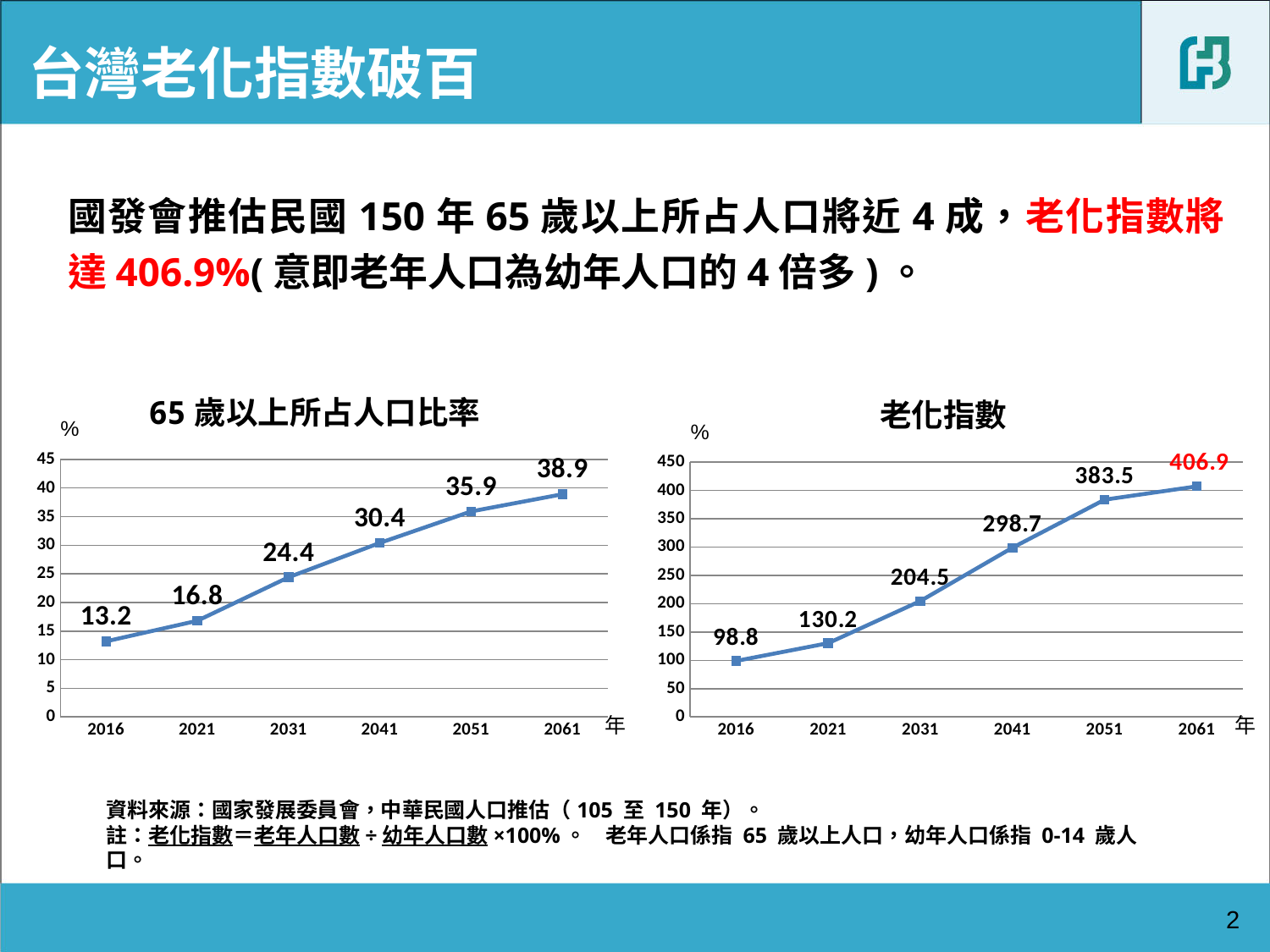
In the chart titled 老化指數, which year has the lowest value? 2016 In the chart titled 老化指數, what is the difference between the values for 2061 and 2016? 308.1 In the chart titled 老化指數, what is the value for 2016? 98.8 What kind of chart is the chart titled 老化指數? line chart In the chart titled 老化指數, which data label is shown in red? 406.9 In the chart titled 老化指數, do the values rise or fall from 2016 to 2061? rise In the chart titled 65歲以上所占人口比率, which year has the highest value? 2061 How many data points are plotted in the chart titled 65歲以上所占人口比率? 6 In the chart titled 65歲以上所占人口比率, what is the value for 2031? 24.4 In the chart titled 老化指數, what is the value for 2041? 298.7 In the chart titled 老化指數, which is larger, the value for 2031 or the value for 2021? 2031 In the chart titled 65歲以上所占人口比率, what is the difference between the values for 2051 and 2041? 5.5